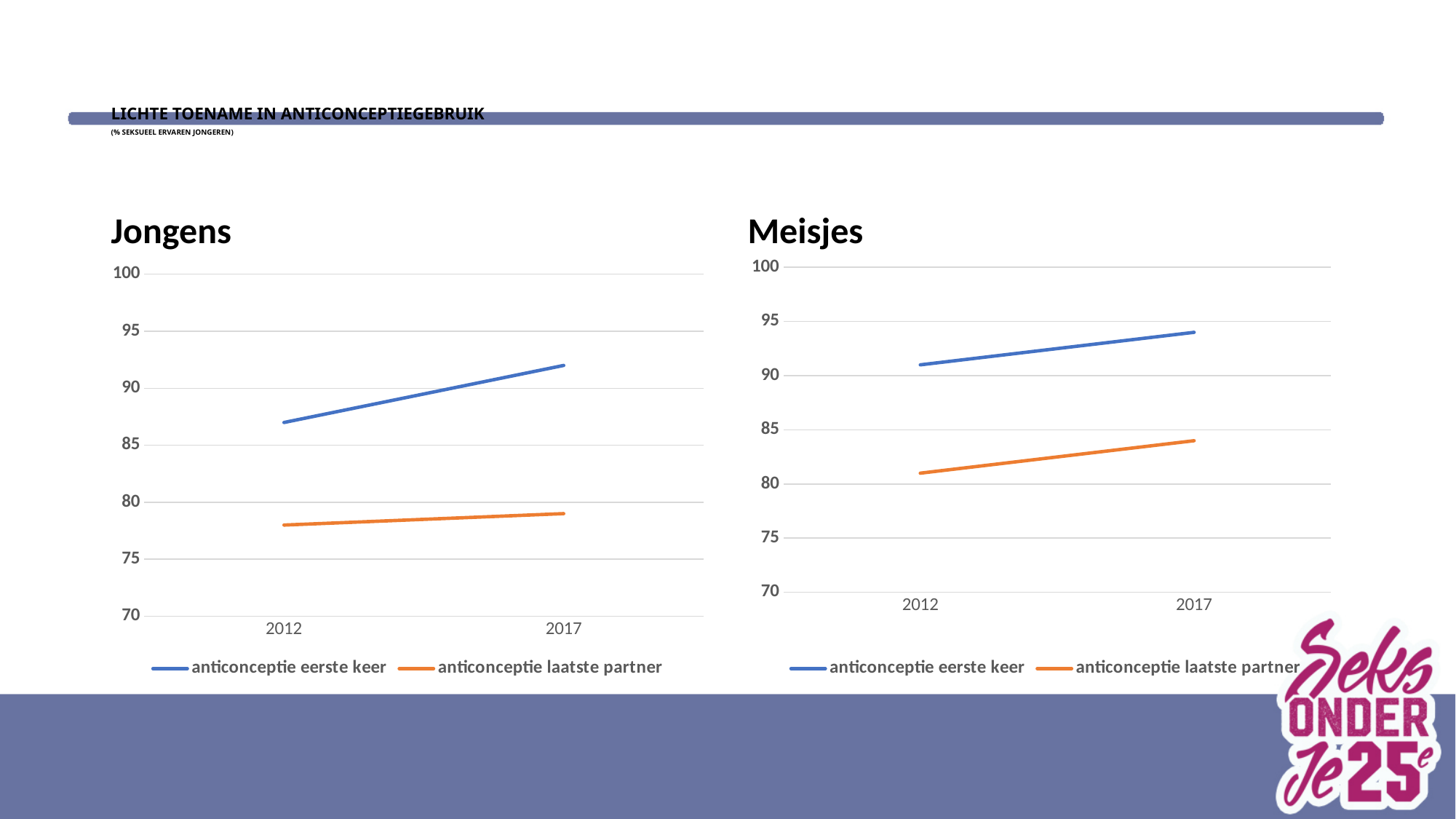
In the Meisjes chart, is the value for anticonceptie laatste partner in 2012 greater or less than 85? less What is the title of the slide above the two charts? LICHTE TOENAME IN ANTICONCEPTIEGEBRUIK What kind of chart is the Jongens chart? line chart In the Jongens chart, is the value for anticonceptie laatste partner in 2012 greater or less than 80? less How many series does the legend of the Meisjes chart list? 2 In the Jongens chart, does the value for anticonceptie eerste keer rise or fall from 2012 to 2017? rise In the Jongens chart, which series is shown in orange? anticonceptie laatste partner How many points are on the x axis of the Jongens chart? 2 In the Meisjes chart, does the value for anticonceptie laatste partner rise or fall from 2012 to 2017? rise In the Jongens chart, is the value for anticonceptie eerste keer in 2017 greater or less than 90? greater In the Meisjes chart, which series has the higher value in 2017, anticonceptie eerste keer or anticonceptie laatste partner? anticonceptie eerste keer